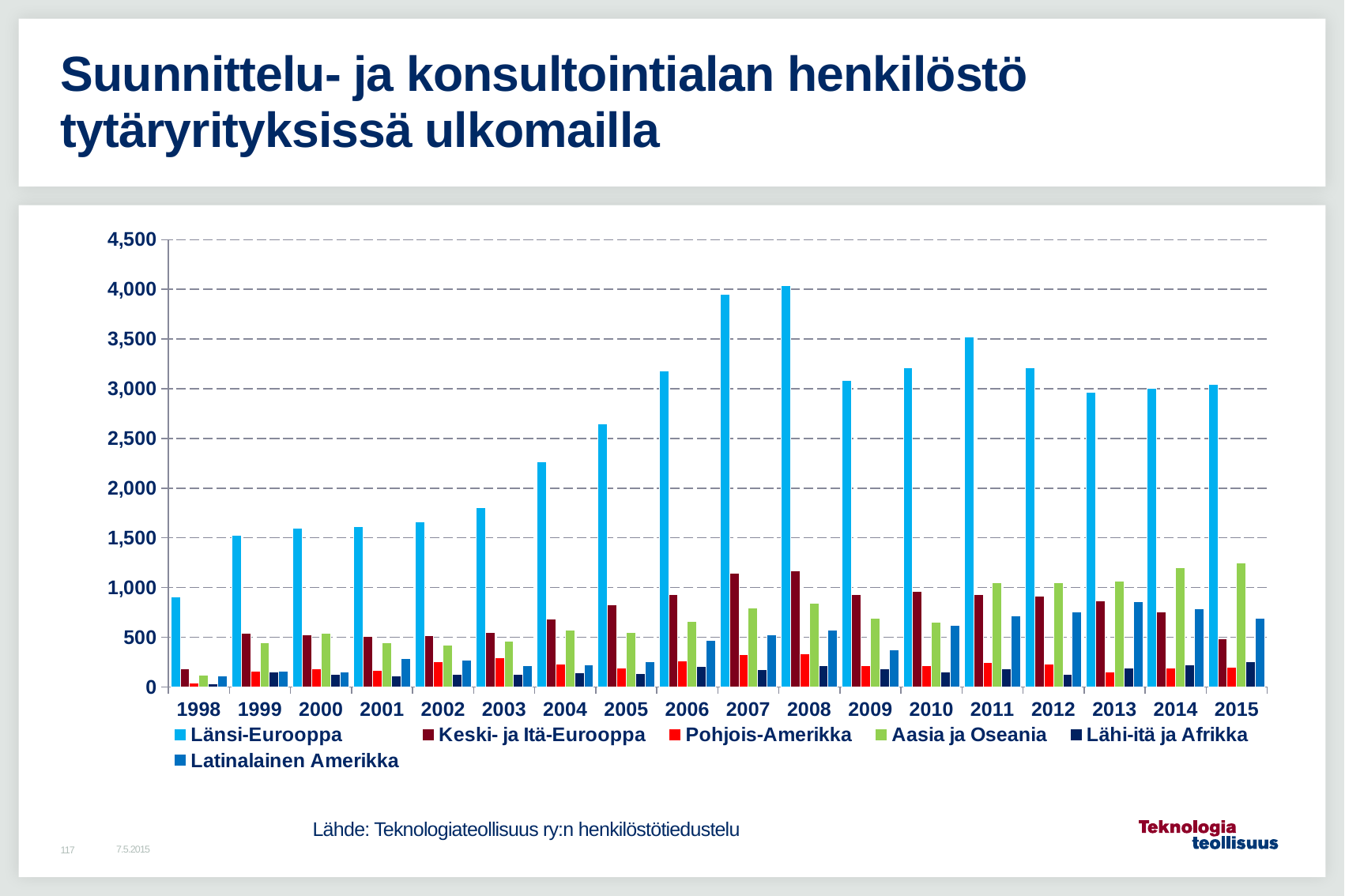
How many series does the legend list? 6 Which is larger for Länsi-Eurooppa: 2008 or 2009? 2008 Is the value for Länsi-Eurooppa in 1998 greater or less than 1,000? less Does the value for Länsi-Eurooppa rise or fall from 1998 to 2008? rise What is the first series listed in the legend? Länsi-Eurooppa How many years are shown on the x axis? 18 Which is larger in 2015: Aasia ja Oseania or Keski- ja Itä-Eurooppa? Aasia ja Oseania What kind of chart is shown on the slide? bar chart Is the value for Pohjois-Amerikka in 2008 greater or less than 500? less In which year is the value for Länsi-Eurooppa lowest? 1998 Is the value for Aasia ja Oseania in 2015 greater or less than 1,000? greater